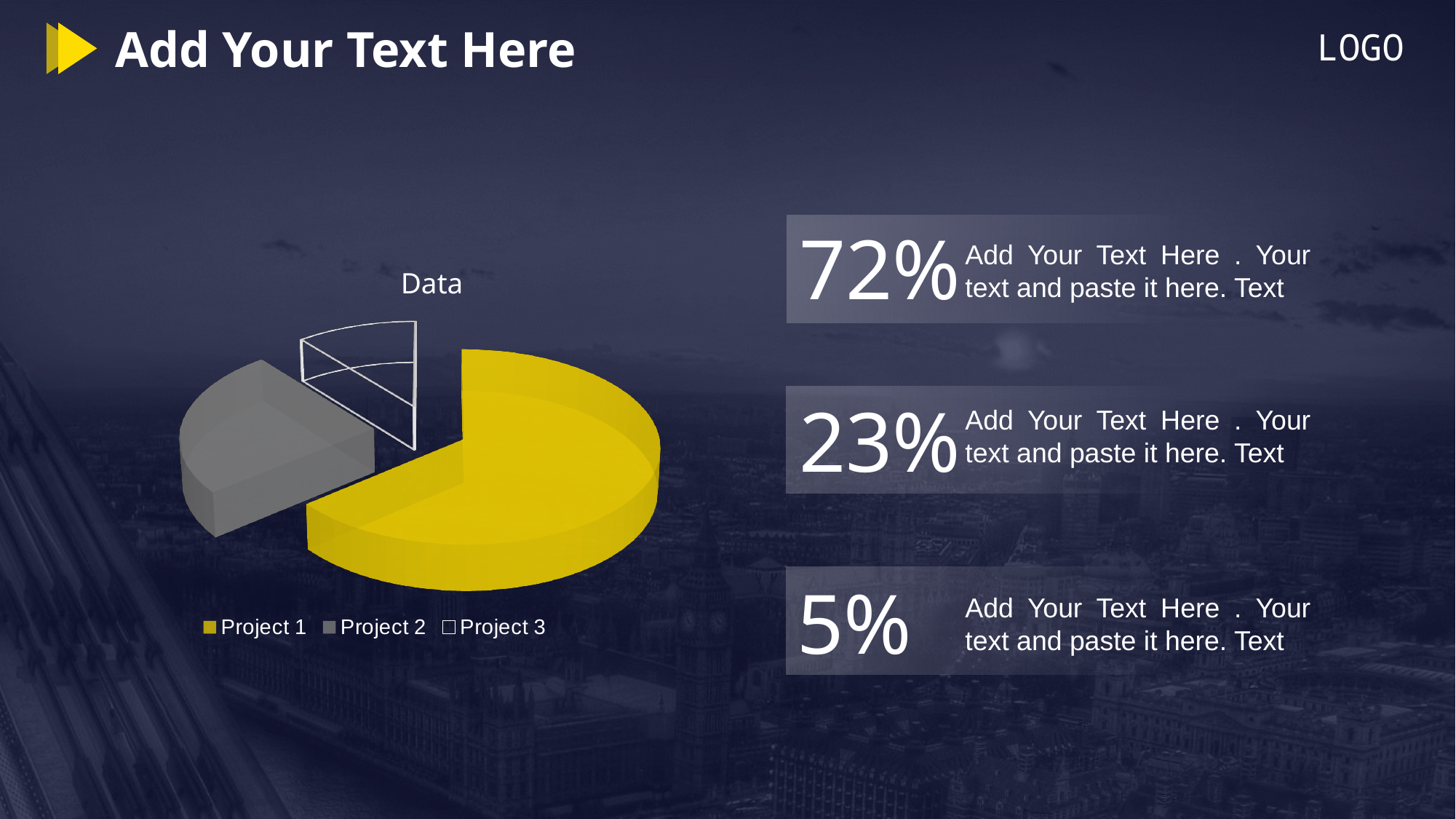
Which category has the smallest slice in the pie chart? Project 3 Which category has the largest slice in the pie chart? Project 1 How many slices does the pie chart have? 3 How many entries does the pie chart's legend list? 3 What kind of chart is shown on the slide? pie chart Which slice is larger in the pie chart, Project 2 or Project 3? Project 2 Which slice is larger in the pie chart, Project 1 or Project 2? Project 1 What colour is the Project 1 slice in the pie chart? yellow Which legend entry is shown in gray in the pie chart? Project 2 What is the title of the pie chart? Data